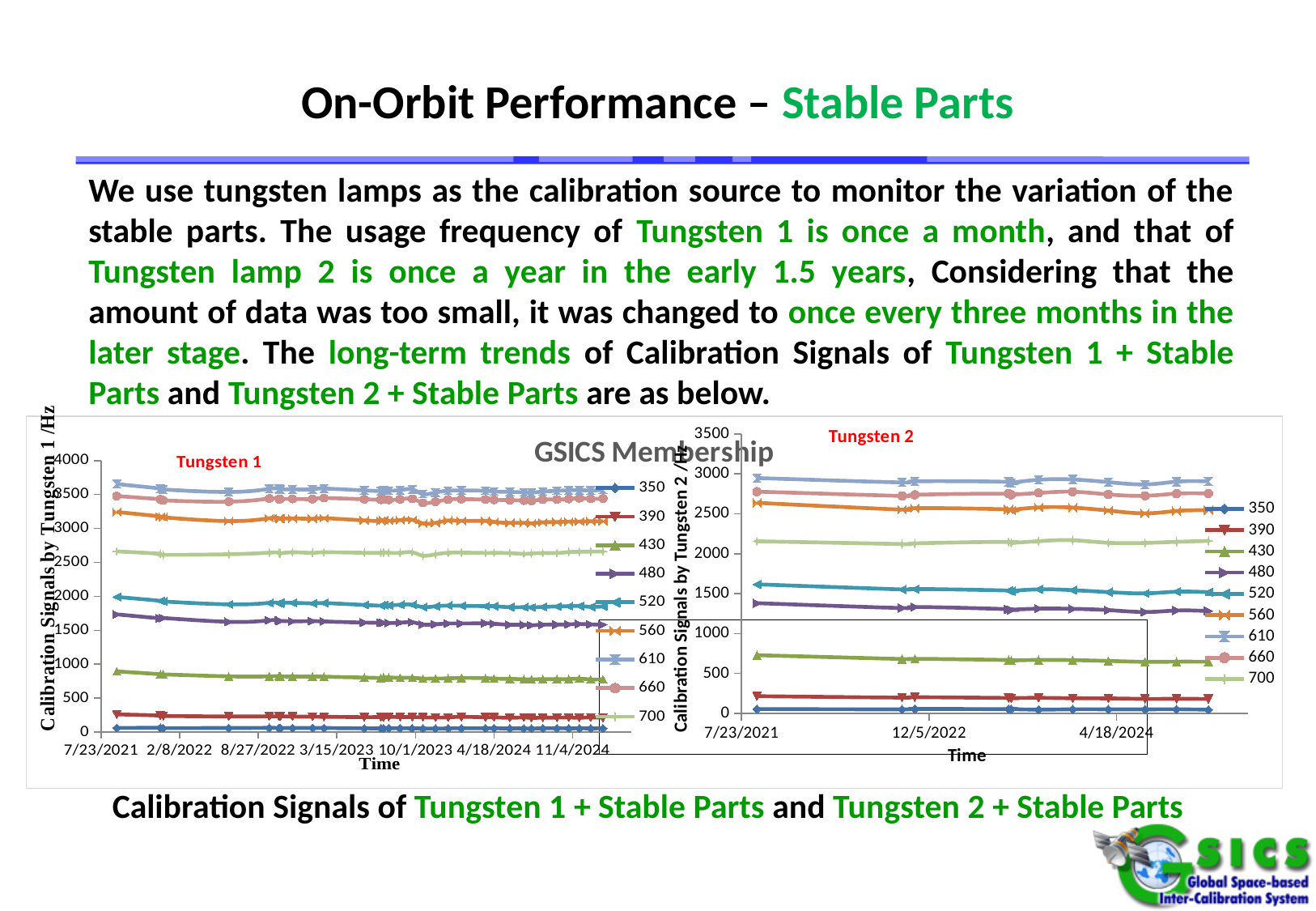
What type of chart is the Tungsten 1 chart on the left? Line chart In the Tungsten 1 chart, are the values for series 560 greater or less than 3000? greater In the Tungsten 1 chart, which series has the highest values? 610 In the Tungsten 2 chart, are the values for series 480 greater or less than 1500? less In the Tungsten 2 chart, which series has the highest values? 610 In the Tungsten 2 chart, are the values for series 700 greater or less than 2000? greater In the Tungsten 2 chart, which series has larger values, 660 or 560? 660 In the Tungsten 1 chart, which series has the lowest values? 350 How many series does the legend of the Tungsten 2 chart list? 9 What is the label of the y-axis on the Tungsten 2 chart? Calibration Signals by Tungsten 2 /Hz In the Tungsten 1 chart, which series has larger values, 560 or 700? 560